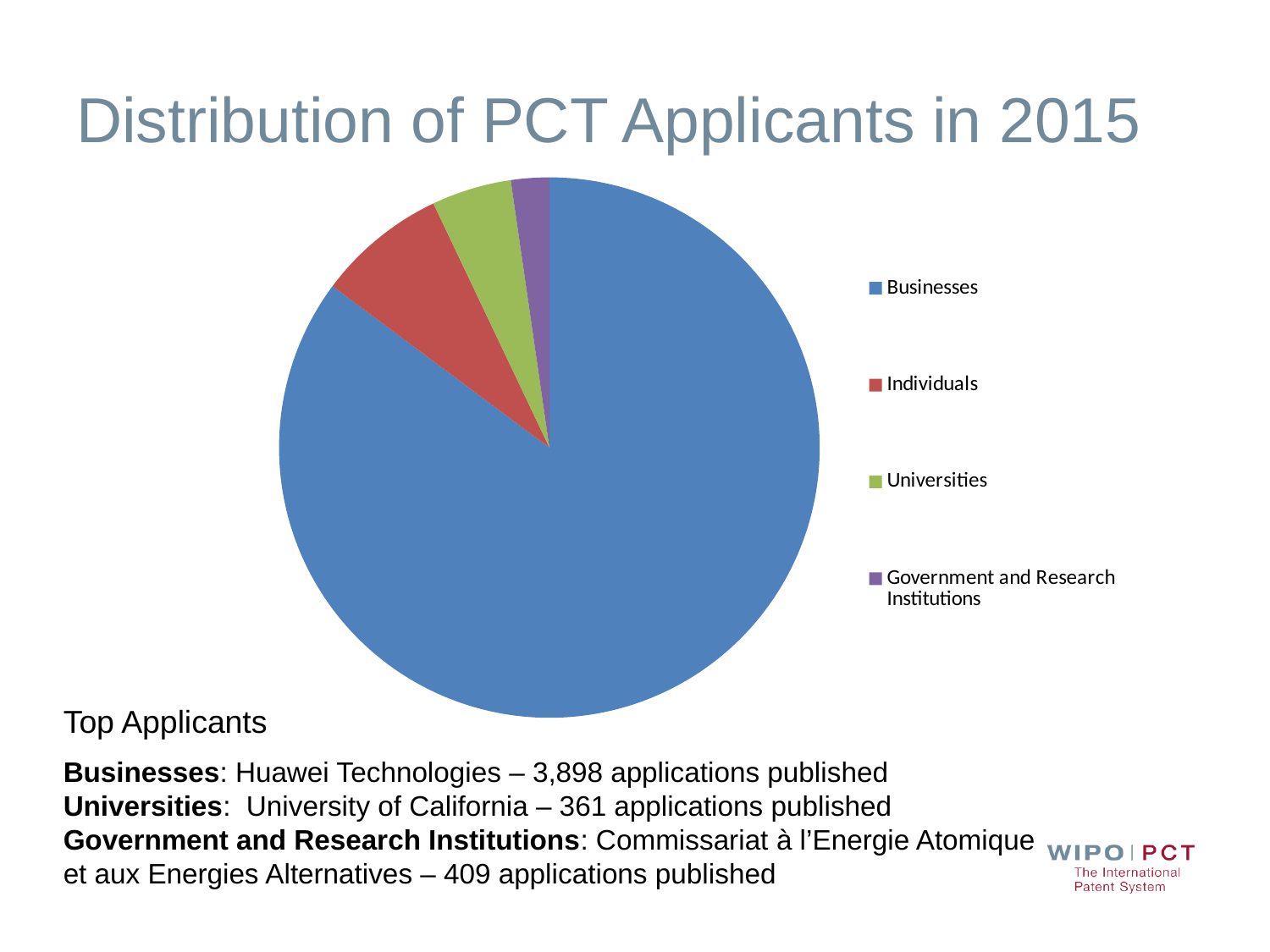
How many entries does the legend list? 4 How many categories does the pie chart show? 4 Which colour represents Universities in the pie chart? green Which has the larger share of the pie, Universities or Government and Research Institutions? Universities Which category has the smallest share of the pie? Government and Research Institutions Which has the larger share of the pie, Individuals or Universities? Individuals Which has the larger share of the pie, Businesses or Individuals? Businesses What is the title of the slide's chart? Distribution of PCT Applicants in 2015 What kind of chart is shown on the slide? pie chart Which category has the largest share of the pie? Businesses